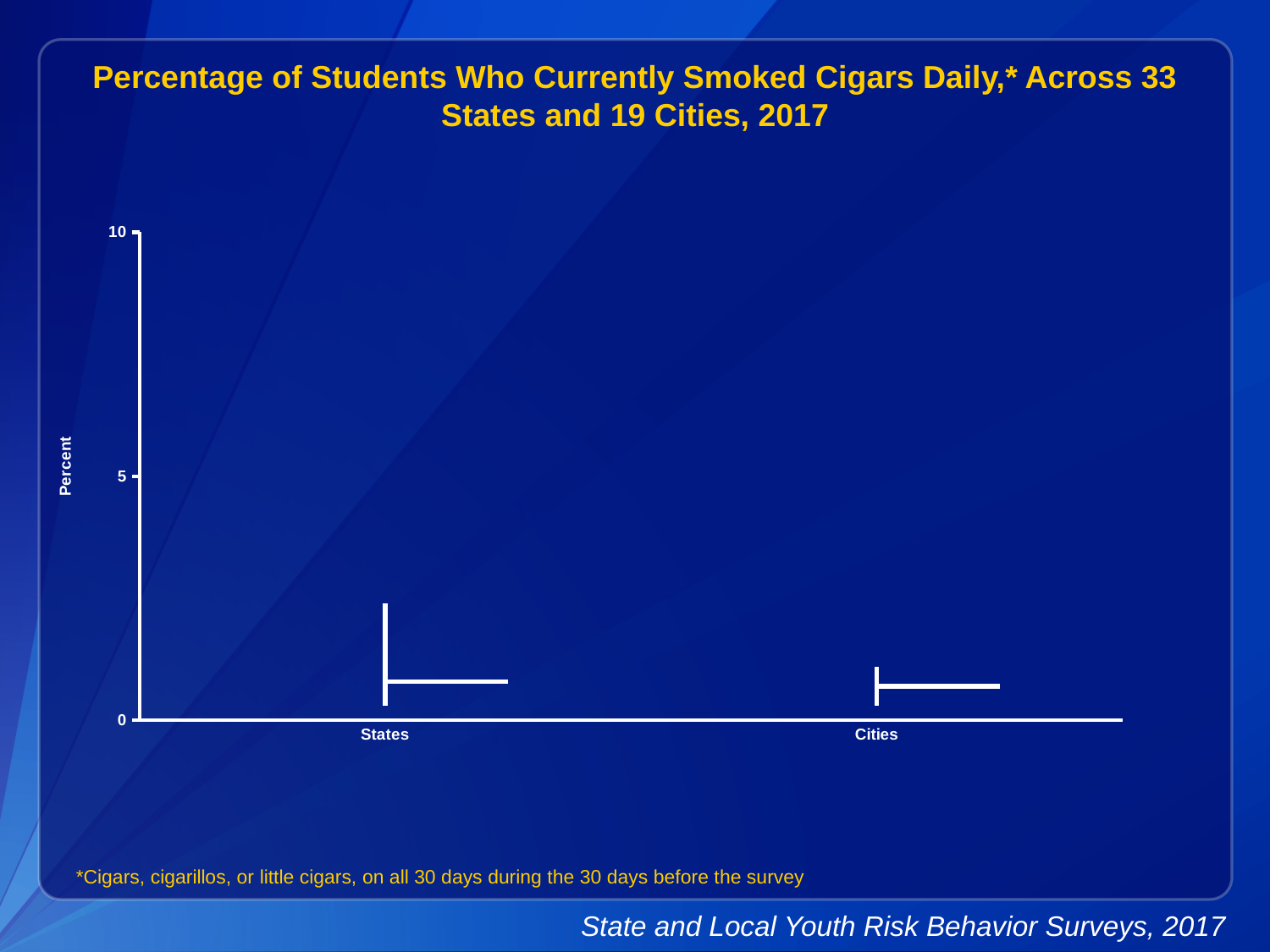
How many categories are shown on the x axis of the chart? 2 What is the label on the y axis of the chart? Percent Which category has the higher upper end of its range, States or Cities? States What is the maximum value shown on the y axis? 10 Is the value for Cities greater or less than 5? less Is the value for States greater or less than 5? less What are the two categories shown on the x axis? States and Cities Is the highest point of the States range greater or less than 5? less What is the title of the chart? Percentage of Students Who Currently Smoked Cigars Daily,* Across 33 States and 19 Cities, 2017